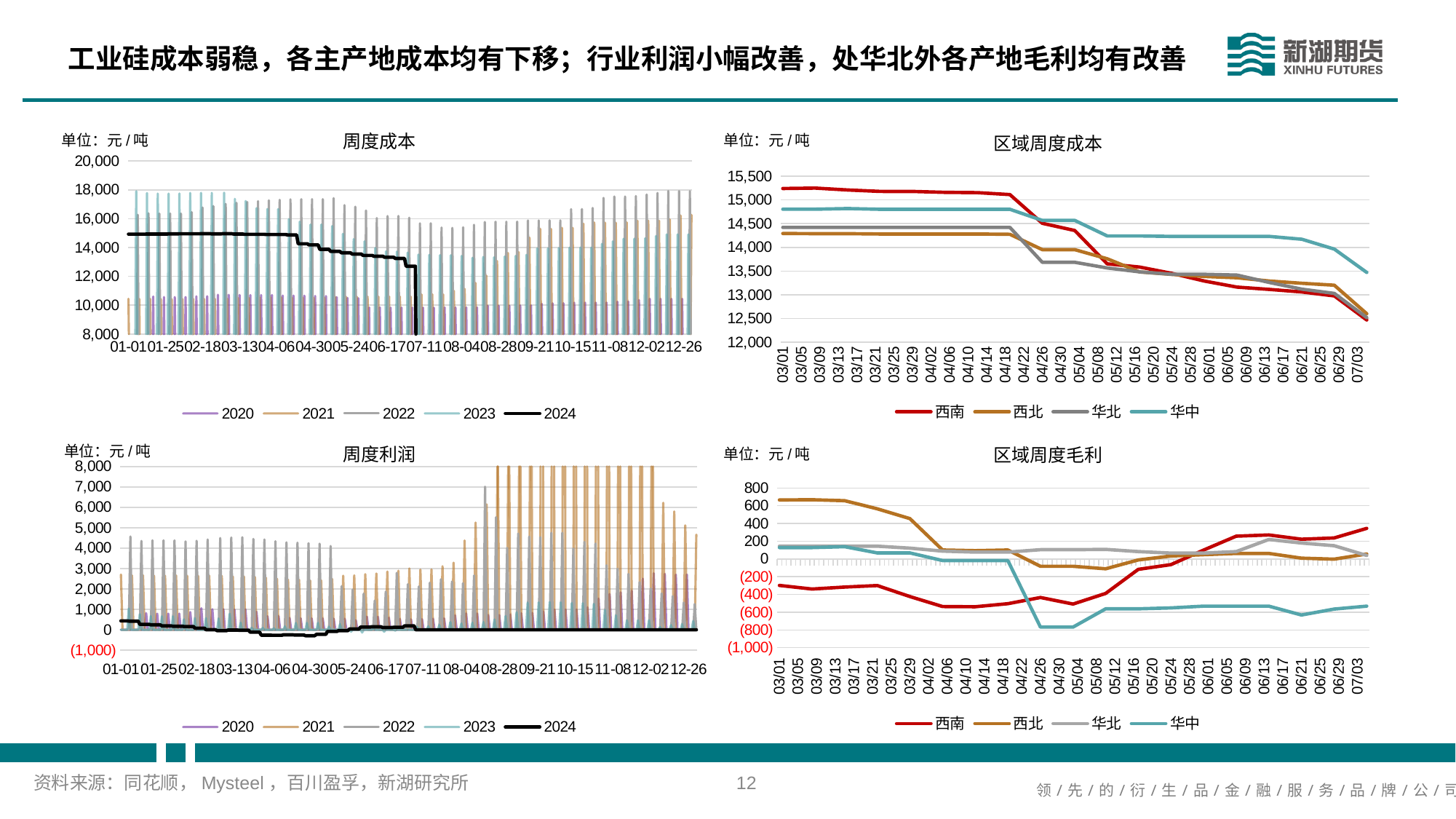
In the 区域周度成本 chart, which region has the highest cost at 07/03? 华中 In the 区域周度成本 chart, does the 西南 line rise or fall from 03/01 to 07/03? fall In the 区域周度毛利 chart, which region has the highest gross margin at 03/01? 西北 How many series does the legend of the 周度成本 chart list? 5 In the 区域周度毛利 chart, is the value for 西南 at 07/03 greater or less than 200? greater How many series does the legend of the 区域周度成本 chart list? 4 What unit is shown for the 周度利润 chart? 元/吨 What kind of chart is the 区域周度毛利 chart? line chart In the 区域周度毛利 chart, at 03/01 which is larger, the value for 西北 or the value for 西南? 西北 In the 区域周度成本 chart, is the value for 西南 at 03/01 greater or less than 15,000? greater In the 区域周度毛利 chart, which region has the lowest gross margin at 04/26? 华中 In the 区域周度成本 chart, which region has the highest cost at 03/01? 西南